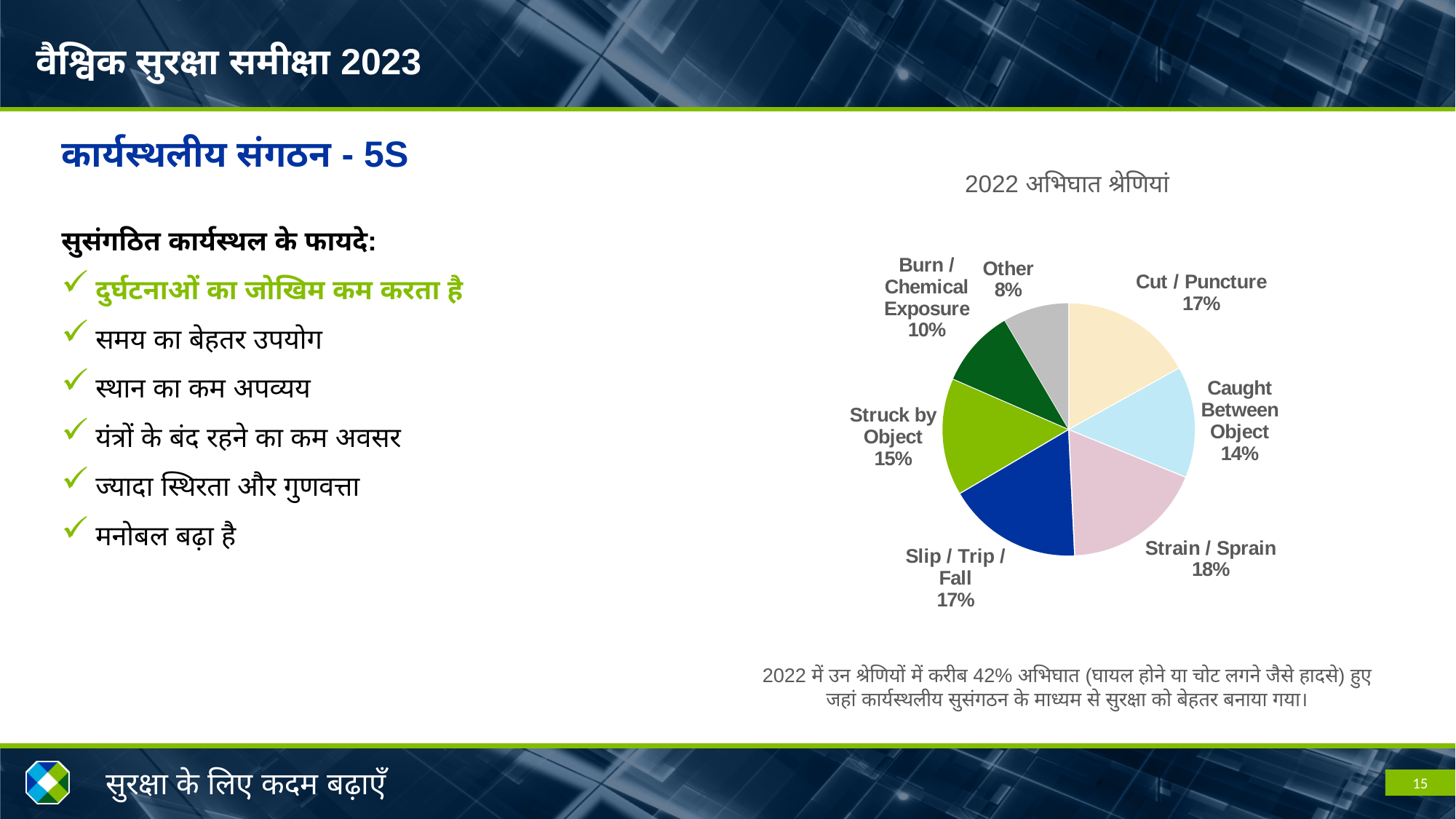
What share of the pie does Burn / Chemical Exposure represent? 10% What share of the pie does Struck by Object represent? 15% What share of the pie does Strain / Sprain represent? 18% What share of the pie does Caught Between Object represent? 14% Which is larger, the share for Struck by Object or the share for Caught Between Object? Struck by Object What is the combined share of Cut / Puncture and Slip / Trip / Fall? 34% What colour is the Slip / Trip / Fall slice? Dark blue Which category has the smallest share of the pie? Other How many categories are shown in the pie chart? 7 What kind of chart is shown on the slide? Pie chart What is the difference in percentage points between Strain / Sprain and Other? 10 Which category has the largest share of the pie? Strain / Sprain